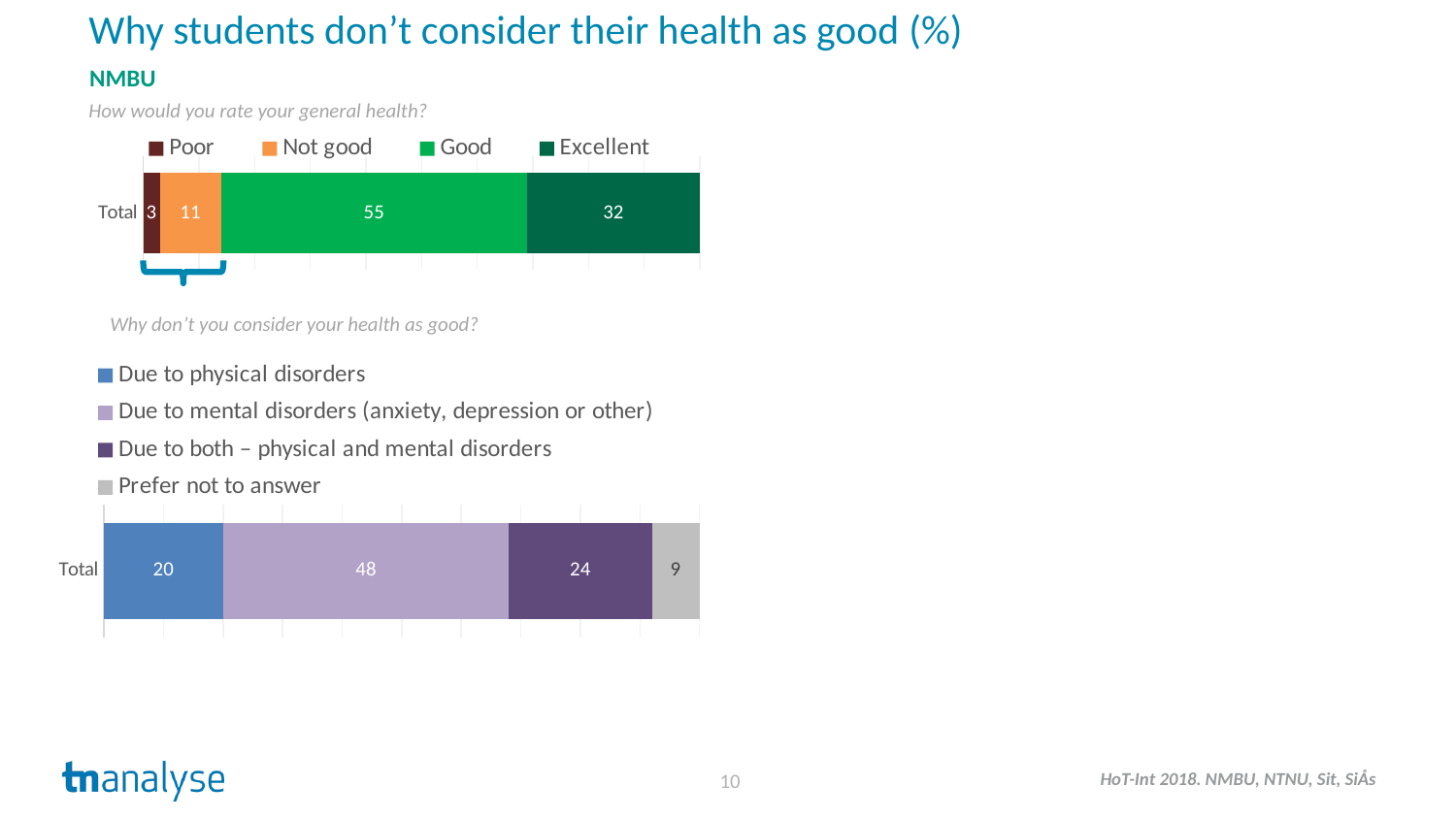
In the top chart (How would you rate your general health?), what is the difference between Good and Excellent? 23 In the bottom chart (Why don't you consider your health as good?), what is the difference between 'Due to mental disorders' and 'Due to physical disorders'? 28 In the top chart (How would you rate your general health?), which category has the lowest value? Poor What type of chart is the bottom chart (Why don't you consider your health as good?)? Stacked bar chart In the top chart (How would you rate your general health?), what is the value for Poor? 3 In the bottom chart (Why don't you consider your health as good?), what is the value for 'Prefer not to answer'? 9 In the bottom chart (Why don't you consider your health as good?), what is the value for 'Due to mental disorders (anxiety, depression or other)'? 48 In the top chart (How would you rate your general health?), how many series does the legend list? 4 In the top chart (How would you rate your general health?), what is the value for Excellent? 32 In the bottom chart (Why don't you consider your health as good?), which is larger: 'Due to physical disorders' or 'Due to both – physical and mental disorders'? Due to both – physical and mental disorders In the top chart (How would you rate your general health?), which category has the highest value? Good In the top chart (How would you rate your general health?), what percentage of students rated their health as Good? 55